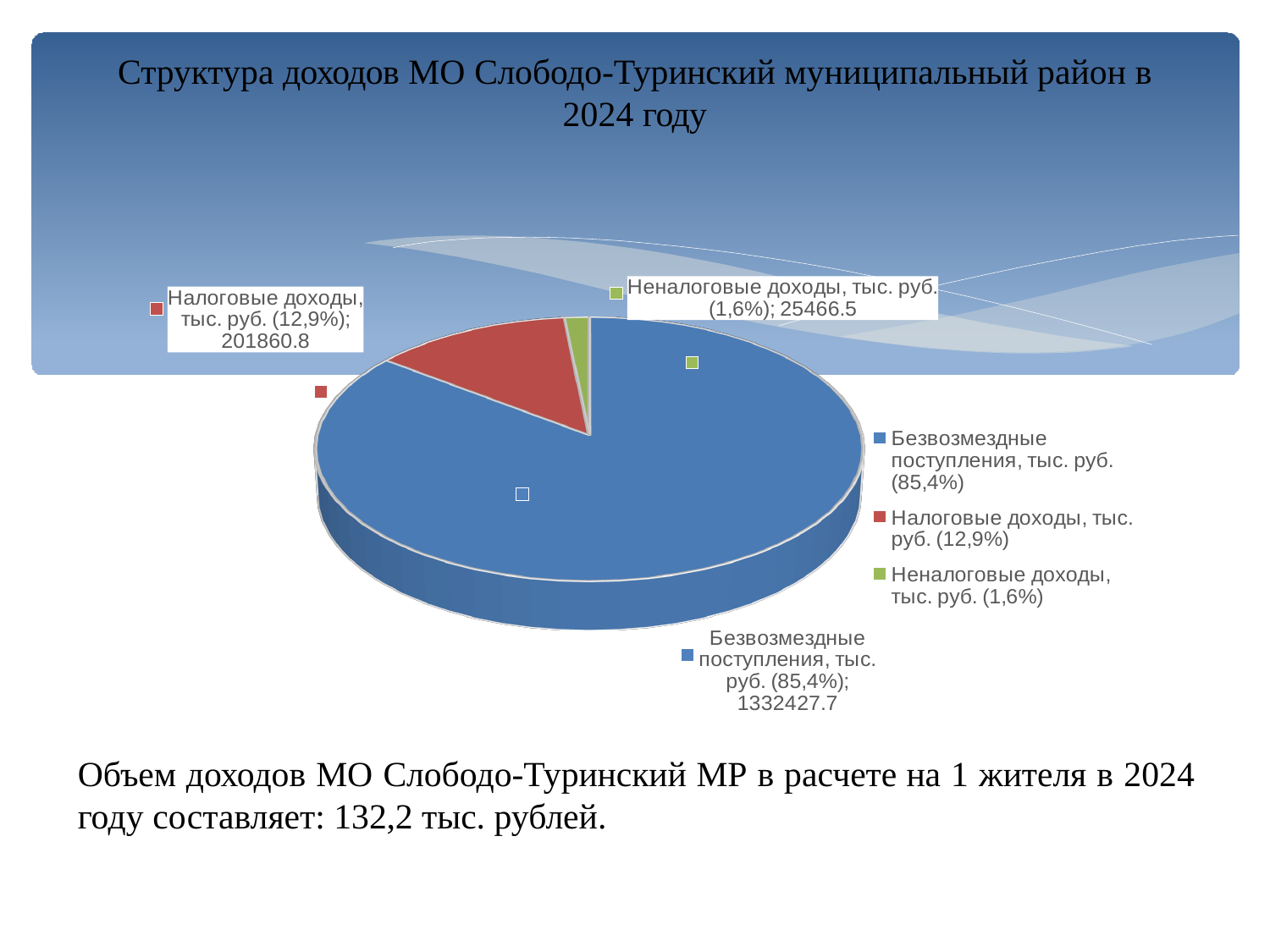
What is the value for Неналоговые доходы, тыс. руб.? 25466.5 Which category has the largest slice of the pie? Безвозмездные поступления, тыс. руб. What share of the pie does Налоговые доходы represent? 12,9% What share of the pie does Безвозмездные поступления represent? 85,4% What is the value for Налоговые доходы, тыс. руб.? 201860.8 What is the difference between the values for Налоговые доходы and Неналоговые доходы? 176394.3 Which is larger, the value for Налоговые доходы or the value for Неналоговые доходы? Налоговые доходы What kind of chart is shown on the slide? pie chart What is the value for Безвозмездные поступления, тыс. руб.? 1332427.7 What share of the pie does Неналоговые доходы represent? 1,6% Which category has the smallest slice of the pie? Неналоговые доходы, тыс. руб. How many categories does the pie chart have? 3